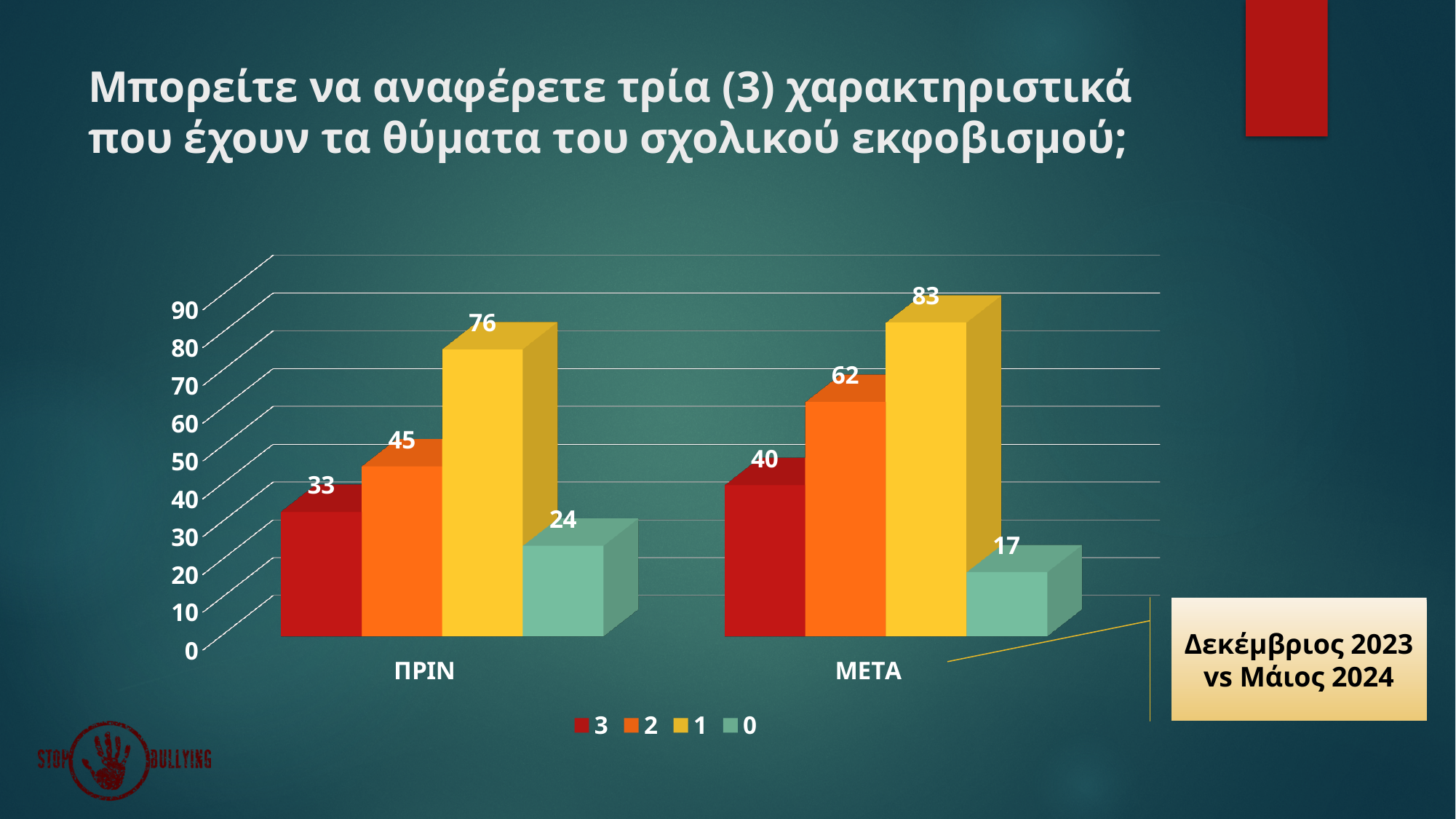
What is the value for series "1" in the ΠΡΙΝ category? 76 Which is larger: the value for series "1" in ΠΡΙΝ or in ΜΕΤΑ? ΜΕΤΑ How many categories are shown on the x axis? 2 What text appears in the callout box to the right of the chart? Δεκέμβριος 2023 vs Μάιος 2024 What is the difference between the values for series "2" in ΜΕΤΑ and ΠΡΙΝ? 17 How many series does the legend list? 4 What is the value for series "0" in the ΜΕΤΑ category? 17 What is the value for series "3" in the ΜΕΤΑ category? 40 Which series has the lowest value in the ΠΡΙΝ category? 0 What kind of chart is shown on the slide? bar chart Which series has the highest value in the ΜΕΤΑ category? 1 What is the difference between the values for series "0" in ΠΡΙΝ and ΜΕΤΑ? 7